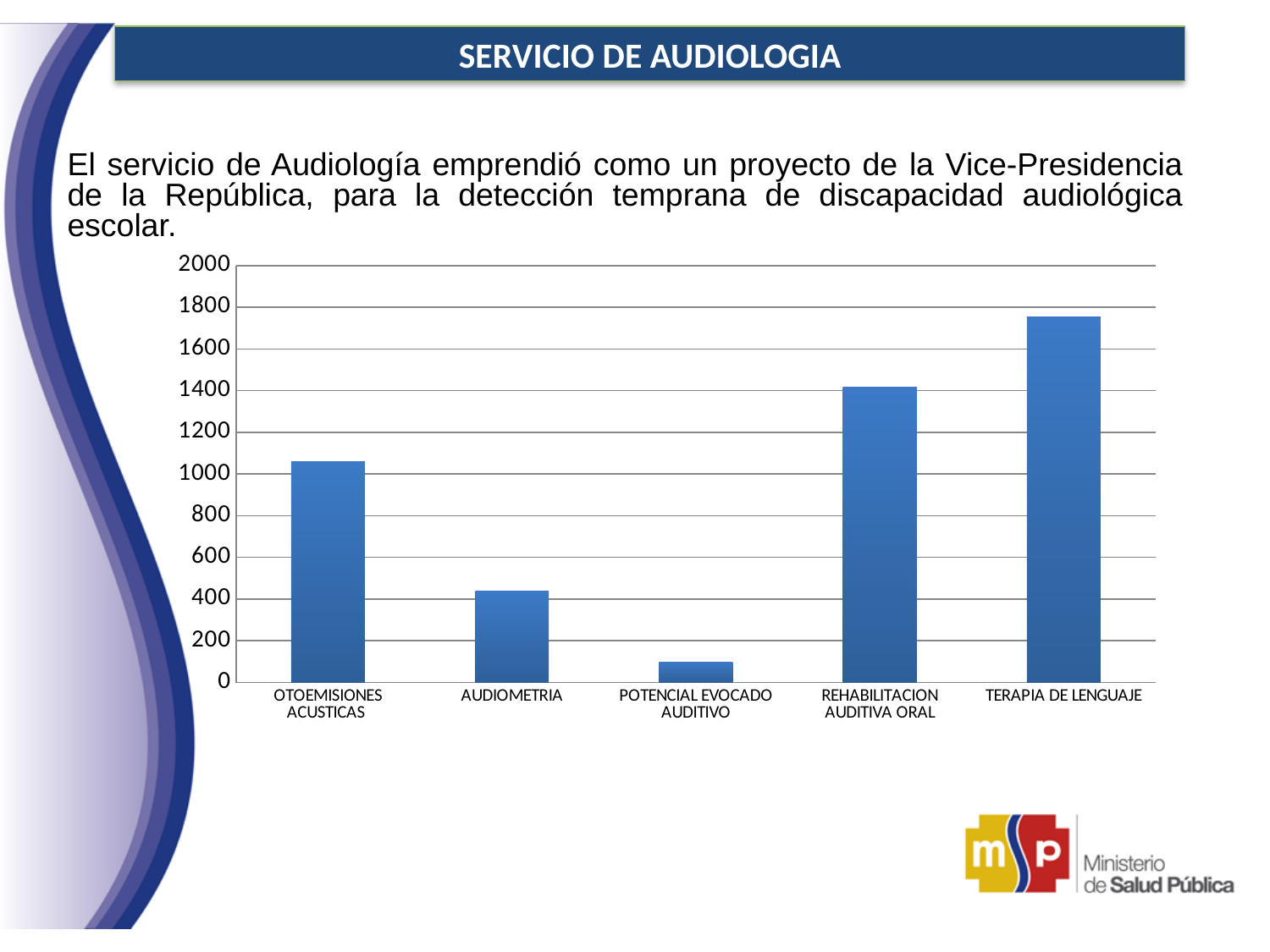
Which is larger, the value for OTOEMISIONES ACUSTICAS or the value for AUDIOMETRIA? OTOEMISIONES ACUSTICAS Is the value for TERAPIA DE LENGUAJE greater or less than 1600? greater What is the maximum value shown on the vertical axis of the chart? 2000 Is the value for REHABILITACION AUDITIVA ORAL greater or less than 1200? greater Is the value for OTOEMISIONES ACUSTICAS greater or less than 1000? greater Which category has the lowest bar in the chart? POTENCIAL EVOCADO AUDITIVO Which is larger, the value for REHABILITACION AUDITIVA ORAL or the value for TERAPIA DE LENGUAJE? TERAPIA DE LENGUAJE What kind of chart is shown on the slide? bar chart Which category has the highest bar in the chart? TERAPIA DE LENGUAJE How many categories are shown on the x axis of the chart? 5